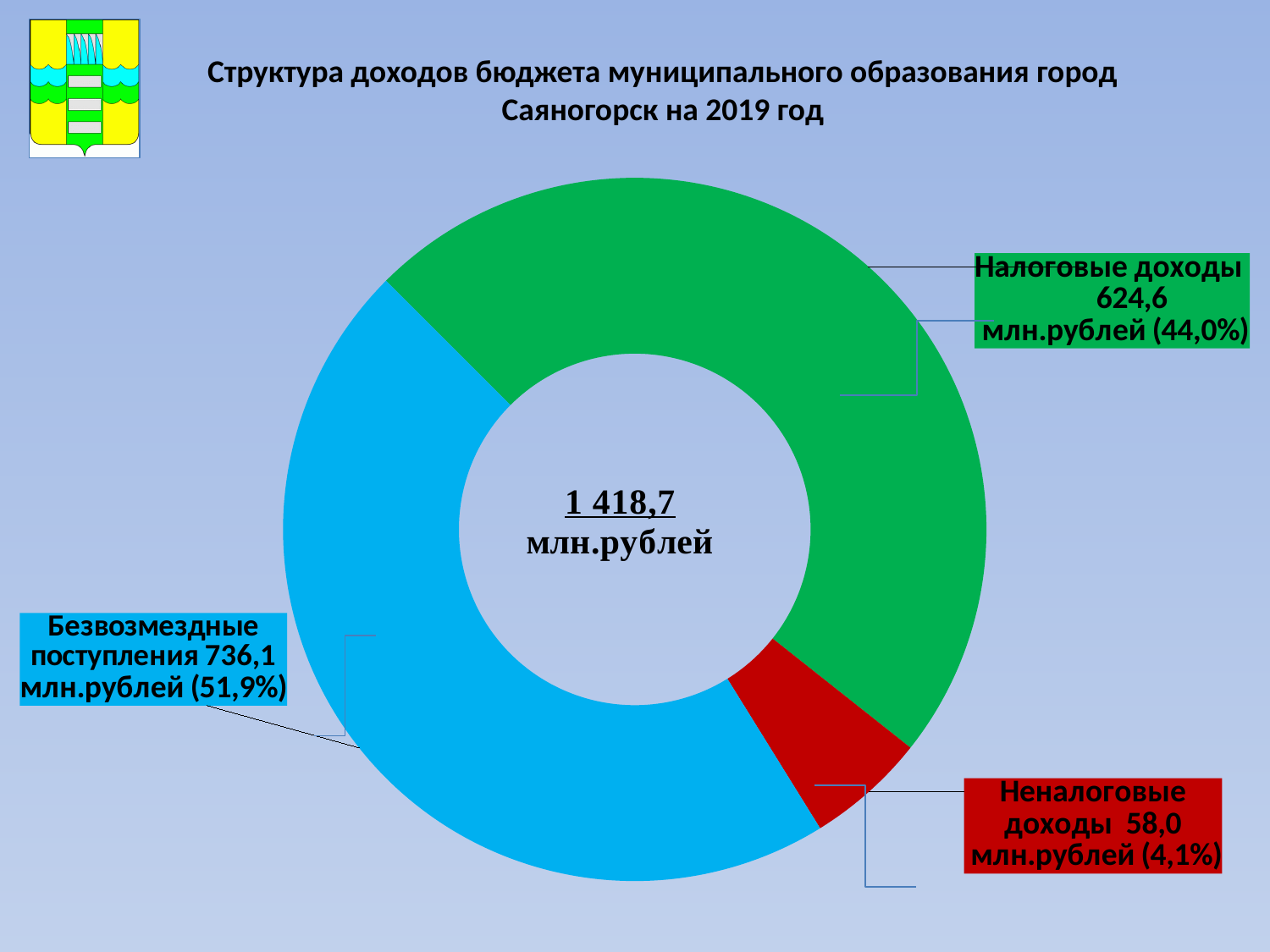
Which category has the smallest value? Неналоговые доходы What is the value for Неналоговые доходы? 58,0 млн.рублей What is the value for Налоговые доходы? 624,6 млн.рублей What total value is shown in the centre of the chart? 1 418,7 млн.рублей What share of the total do Налоговые доходы make up? 44,0% What kind of chart is shown on the slide? Doughnut (pie) chart Which category has the largest value? Безвозмездные поступления What is the value for Безвозмездные поступления? 736,1 млн.рублей Which is larger, Налоговые доходы or Неналоговые доходы? Налоговые доходы What is the difference between Безвозмездные поступления and Налоговые доходы? 111,5 млн.рублей What share of the total do Неналоговые доходы make up? 4,1% How many categories does the chart show? 3